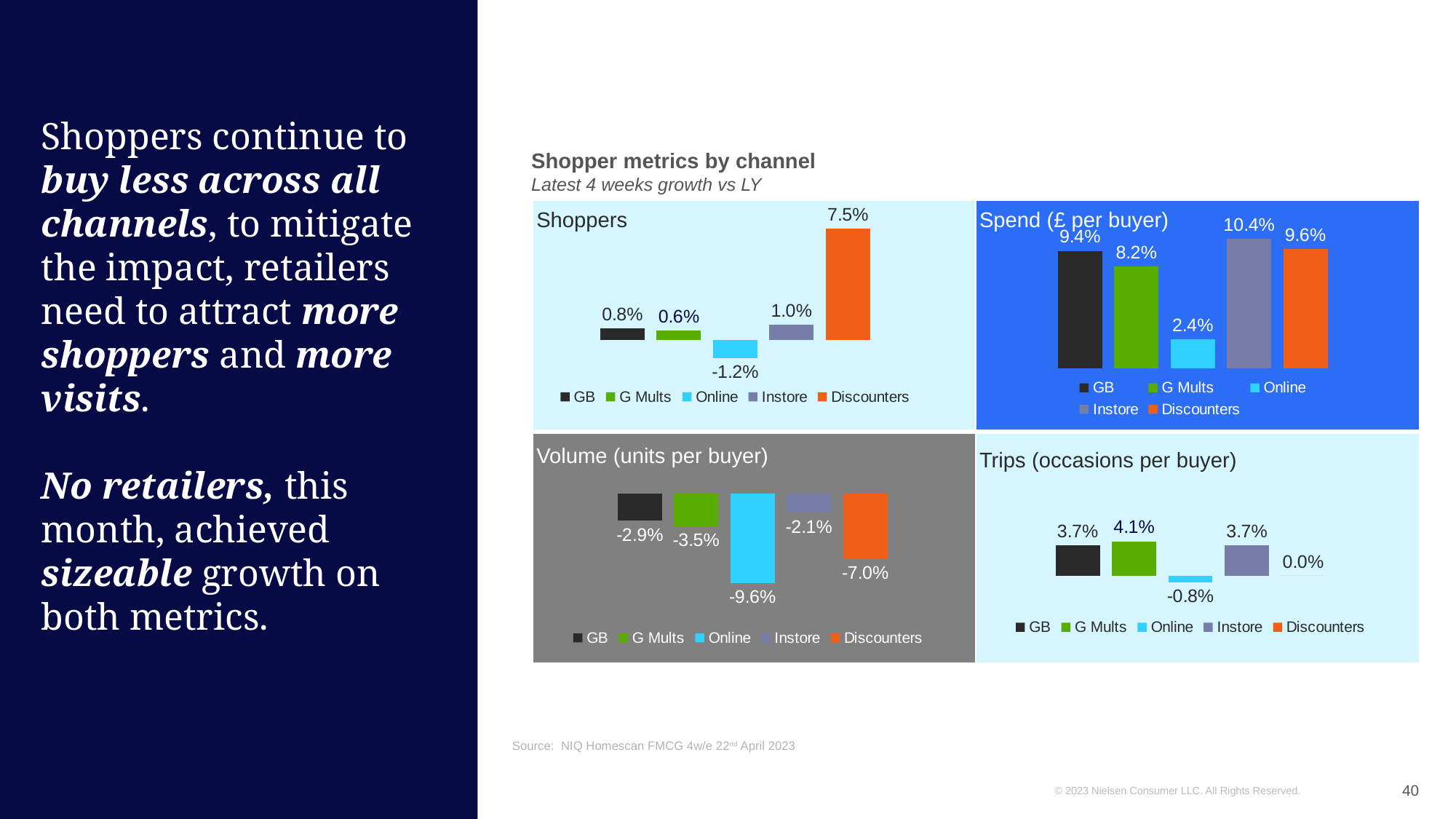
What kind of chart is the Volume (units per buyer) chart? Bar chart In the Volume (units per buyer) chart, what is the value for Online? -9.6% In the Shoppers chart, what is the value for Discounters? 7.5% In the Trips (occasions per buyer) chart, what is the value for Discounters? 0.0% In the Spend (£ per buyer) chart, what is the difference between the GB and G Mults values? 1.2% How many charts are shown on the slide? 4 In the Shoppers chart, which channel has the lowest value? Online In the Spend (£ per buyer) chart, which channel has the highest value? Instore How many series does the legend of the Shoppers chart list? 5 In the Volume (units per buyer) chart, which channel has the lowest value? Online In the Spend (£ per buyer) chart, what is the value for Online? 2.4% In the Trips (occasions per buyer) chart, which is larger, the value for G Mults or the value for Online? G Mults